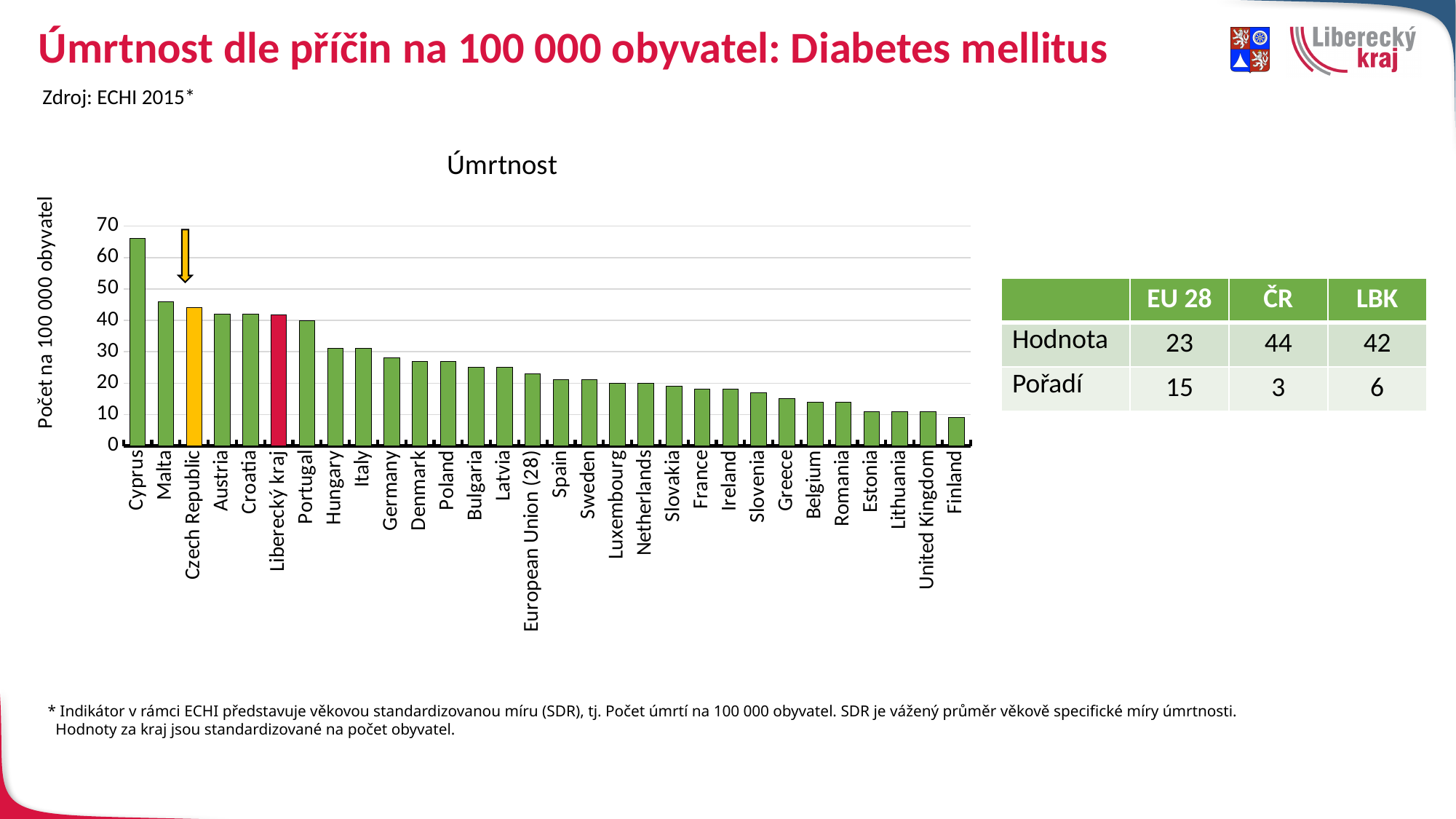
Which country has the highest diabetes mortality in the chart? Cyprus What kind of chart is shown on the slide? bar chart What is the title of the y axis of the chart? Počet na 100 000 obyvatel How many bars (categories) are plotted in the chart? 30 Is the value for Finland greater or less than 10? less Is the value for Cyprus greater or less than 60? greater Do the values rise or fall from left to right along the x axis? fall Which country has the lowest value in the chart? Finland Is the value for Germany greater or less than 30? less Which is larger, the value for Cyprus or the value for Malta? Cyprus What is the value for the Czech Republic, as given in the table next to the chart? 44